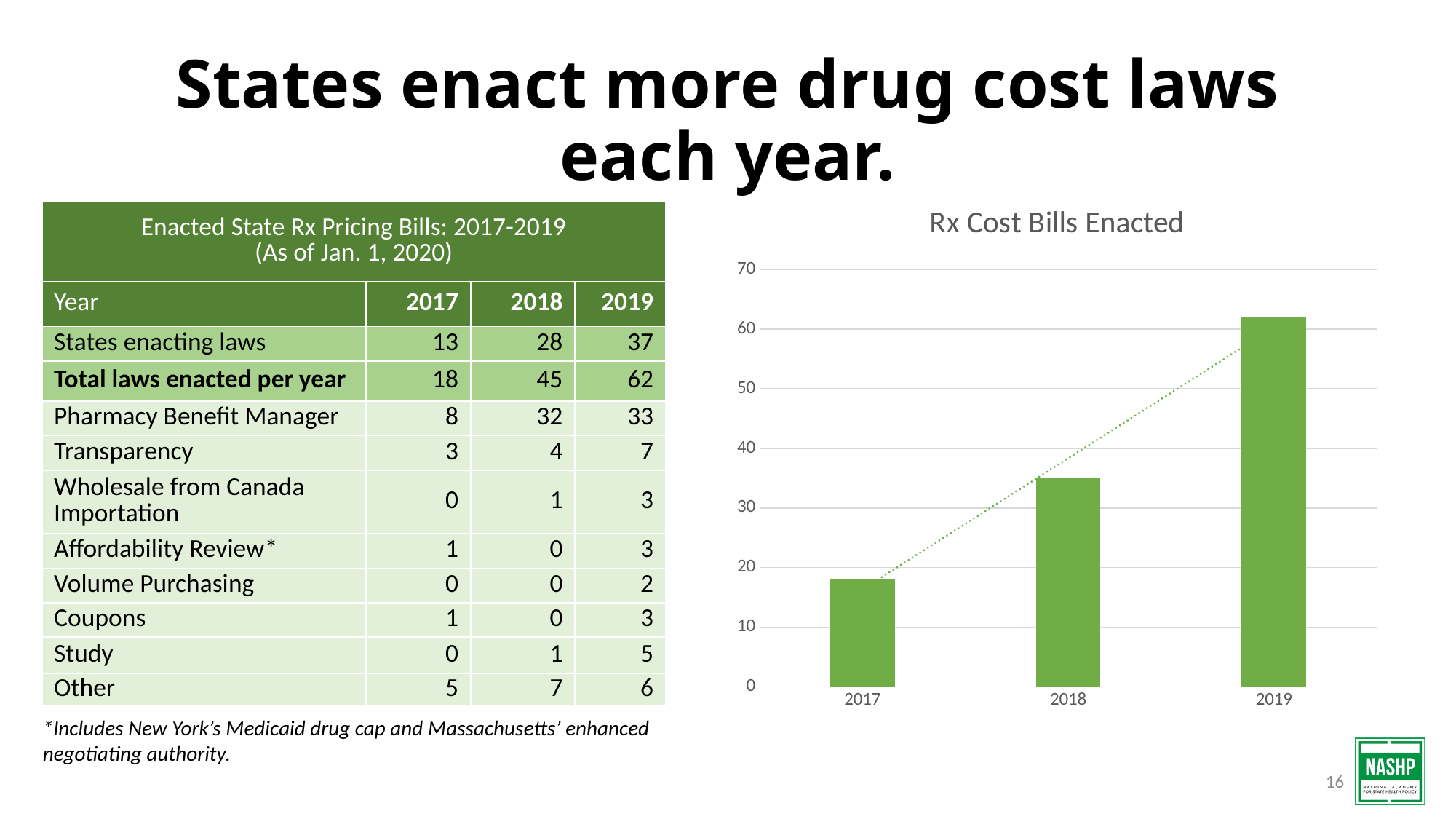
In the "Rx Cost Bills Enacted" chart, is the bar for 2019 greater or less than 60? greater What is the title of the chart on the right side of the slide? Rx Cost Bills Enacted What is the highest value shown on the y axis of the "Rx Cost Bills Enacted" chart? 70 In the "Rx Cost Bills Enacted" chart, which year has the highest bar? 2019 In the "Rx Cost Bills Enacted" chart, is the bar for 2018 greater or less than 40? less What kind of chart is "Rx Cost Bills Enacted"? bar chart Do the bars in the "Rx Cost Bills Enacted" chart rise or fall from 2017 to 2019? rise How many years are shown on the x axis of the "Rx Cost Bills Enacted" chart? 3 In the "Rx Cost Bills Enacted" chart, is the bar for 2018 greater or less than 30? greater In the "Rx Cost Bills Enacted" chart, which bar is taller, 2018 or 2019? 2019 In the "Rx Cost Bills Enacted" chart, which year has the lowest bar? 2017